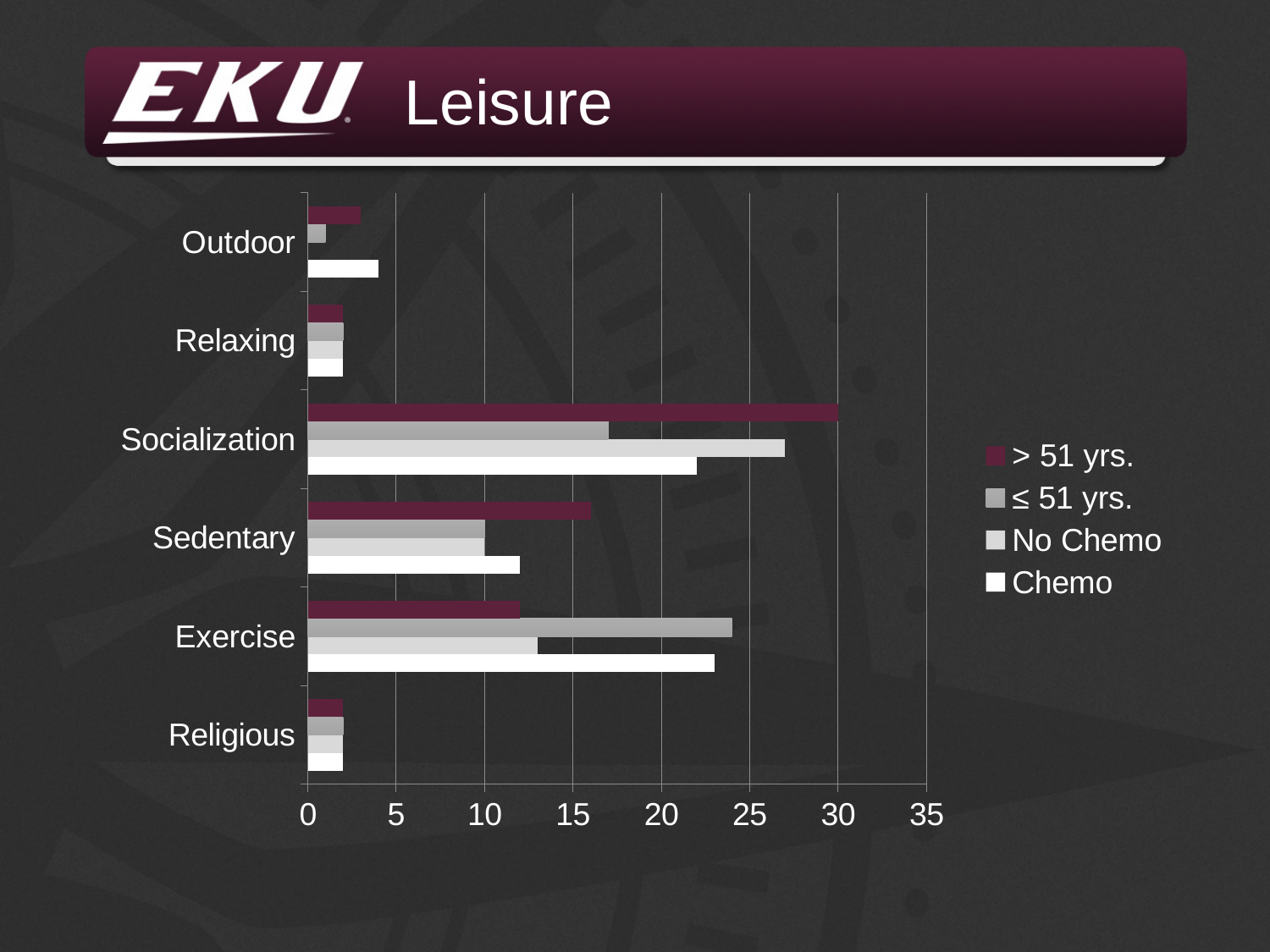
How many leisure categories are shown on the chart? 6 For Exercise, which is larger: the ≤ 51 yrs. value or the No Chemo value? ≤ 51 yrs. For Socialization, which is larger: the > 51 yrs. value or the ≤ 51 yrs. value? > 51 yrs. Which category has the highest value for the > 51 yrs. series? Socialization What is the value for Socialization in the > 51 yrs. series? 30 Is the value for Sedentary in the > 51 yrs. series greater or less than 15? greater How many series does the legend list? 4 Is the value for Socialization in the No Chemo series greater or less than 25? greater Is the value for Exercise in the Chemo series greater or less than 20? greater What kind of chart is shown on the slide? bar chart What is the title of the slide containing the chart? Leisure